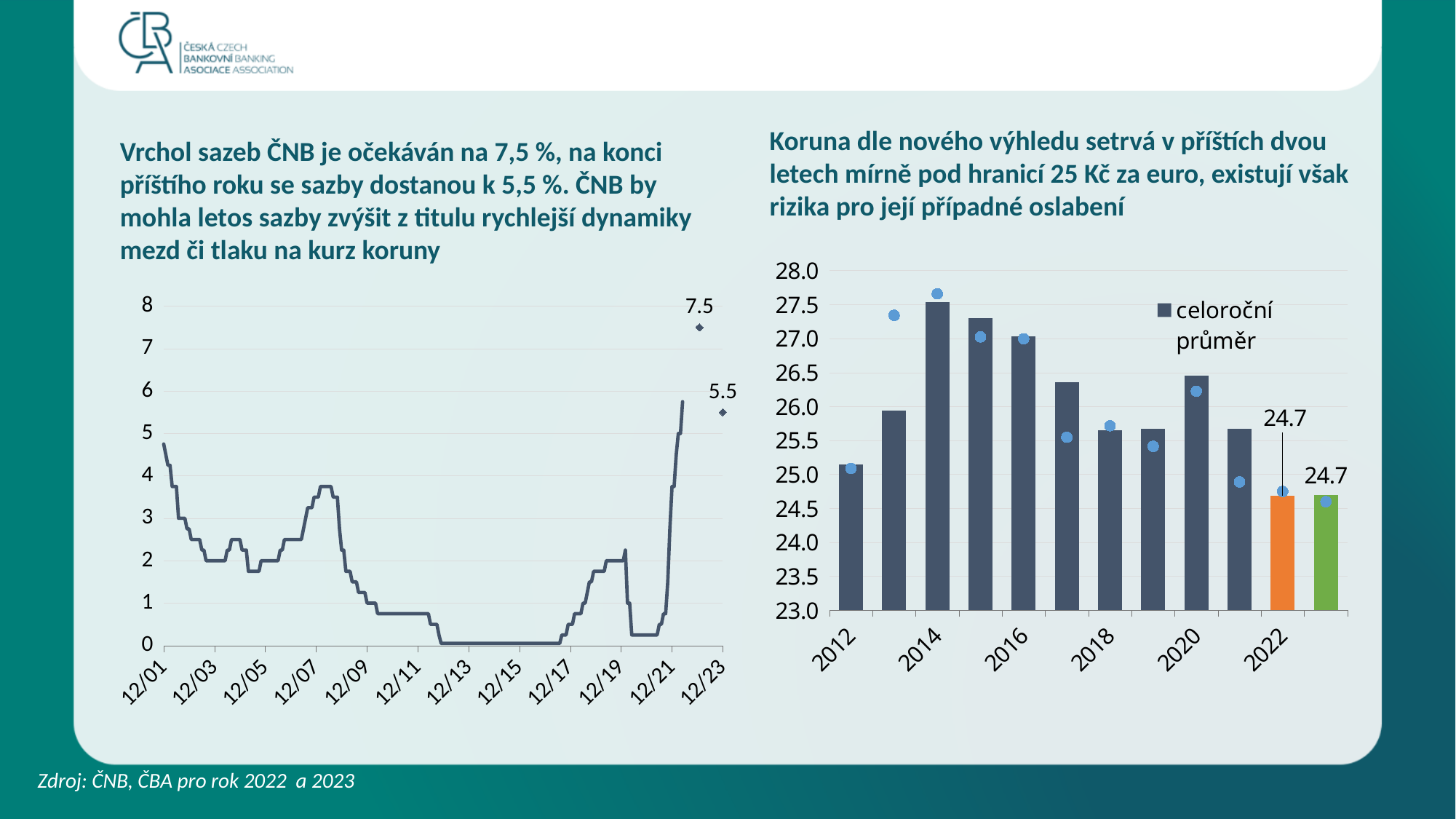
In the right chart, which year has the highest bar? 2014 In the right chart, what series name does the legend show? celoroční průměr In the right chart, is the value for 2020 greater or less than 26.0? greater In the right chart, what is the labelled value for 2022? 24.7 In the left chart, what is the value of the lower labelled point near 12/23? 5.5 In the left chart, does the line rise or fall between 12/19 and 12/21? rise In the left chart, what is the difference between the two labelled points, 7.5 and 5.5? 2 In the left chart, what is the value of the higher labelled point near 12/23? 7.5 In the left chart, is the value at 12/15 greater or less than 1? less In the right chart, how many bars are plotted? 12 What kind of chart is the chart on the right side of the slide? combination bar and line chart (bars with dot markers) What kind of chart is the chart on the left side of the slide? line chart